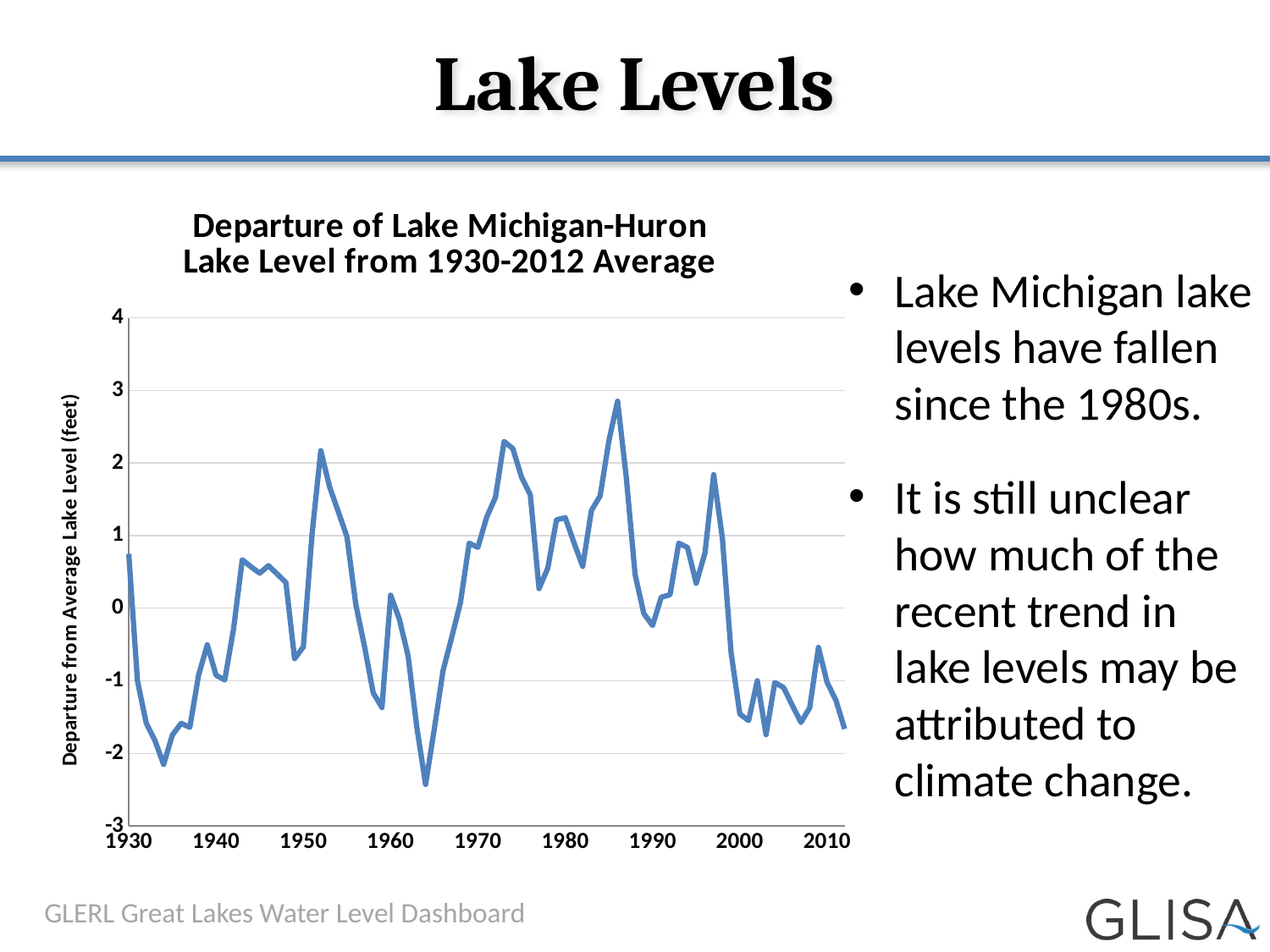
Is the value for 1986 greater or less than 2? greater Is the value for 1930 greater or less than 0? greater What is the label of the vertical axis of the chart? Departure from Average Lake Level (feet) What kind of chart is shown on the slide? line chart What is the title of the chart? Departure of Lake Michigan-Huron Lake Level from 1930-2012 Average Is the value for 1964 greater or less than -2? less Which year has the larger value, 1986 or 2000? 1986 Do the values generally rise or fall between 1986 and 2012? fall In which year does the line reach its lowest value? 1964 In which year does the line reach its highest value? 1986